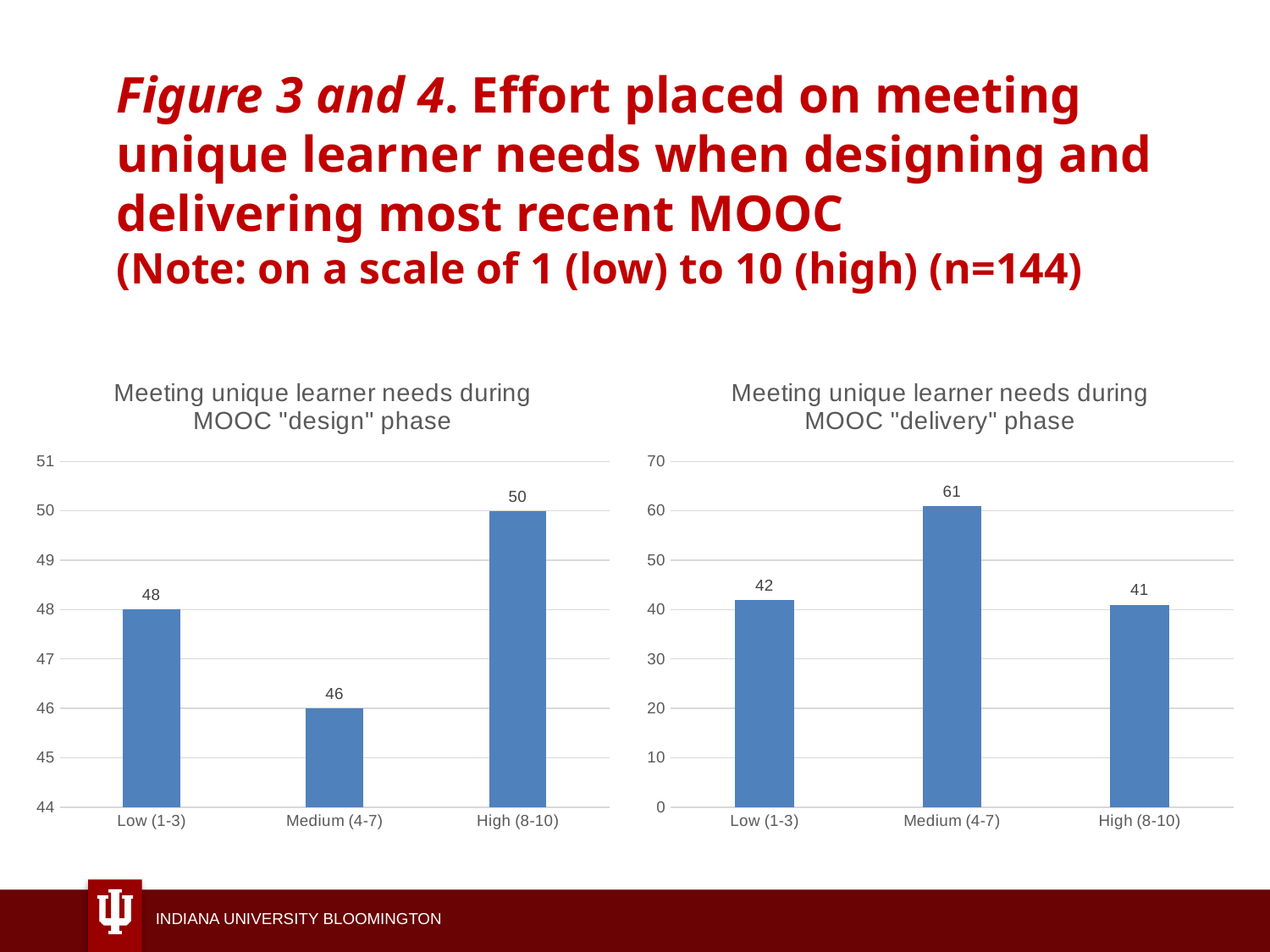
In the 'design' phase chart, which is larger: the value for Low (1-3) or the value for Medium (4-7)? Low (1-3) In the 'delivery' phase chart, is the value for Medium (4-7) greater or less than 50? greater How many categories are shown in the 'delivery' phase chart? 3 In the 'delivery' phase chart, what is the value for Medium (4-7)? 61 In the 'delivery' phase chart, which category has the lowest value? High (8-10) In the 'design' phase chart, what is the difference between the values for High (8-10) and Medium (4-7)? 4 What is the title of the chart on the right side of the slide? Meeting unique learner needs during MOOC "delivery" phase In the 'delivery' phase chart, what is the difference between the values for Medium (4-7) and Low (1-3)? 19 In the 'design' phase chart, what is the value for Medium (4-7)? 46 In the 'design' phase chart, which category has the highest value? High (8-10) In the 'design' phase chart, what is the value for Low (1-3)? 48 What kind of chart is the 'design' phase chart? bar chart